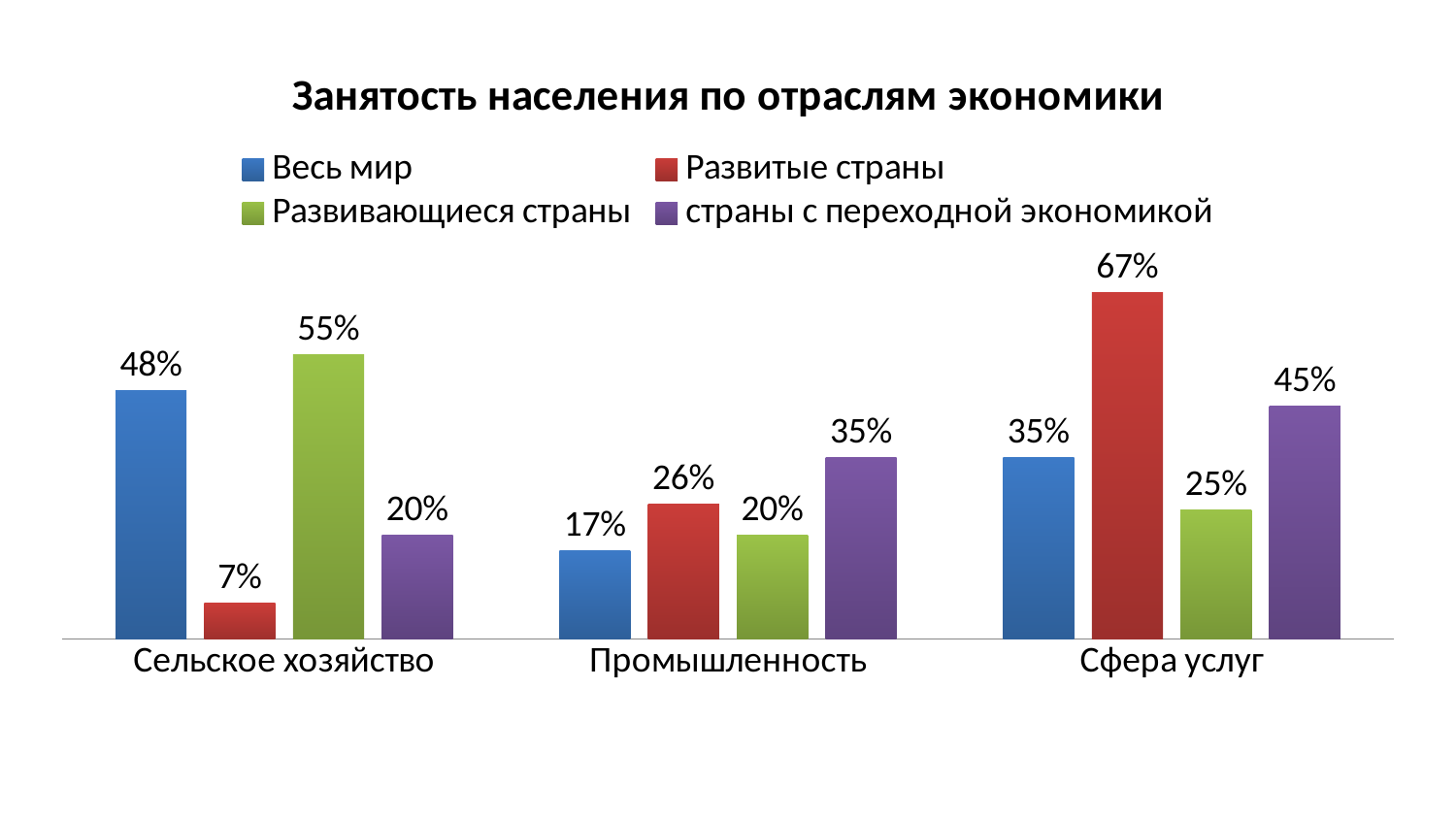
What kind of chart is shown? Bar chart Which series has the highest value in Сфера услуг? Развитые страны How many series does the legend list? 4 Which is larger in Сельское хозяйство: Весь мир or Развивающиеся страны? Развивающиеся страны What is the value for страны с переходной экономикой in Промышленность? 35% How many categories are shown on the x axis? 3 What is the difference between Развитые страны and Весь мир in Сфера услуг? 32% Which colour represents Развивающиеся страны in the legend? Green What is the value for Развивающиеся страны in Сфера услуг? 25% What is the title of the chart? Занятость населения по отраслям экономики What is the value for Развитые страны in Сельское хозяйство? 7% Which series has the lowest value in Промышленность? Весь мир